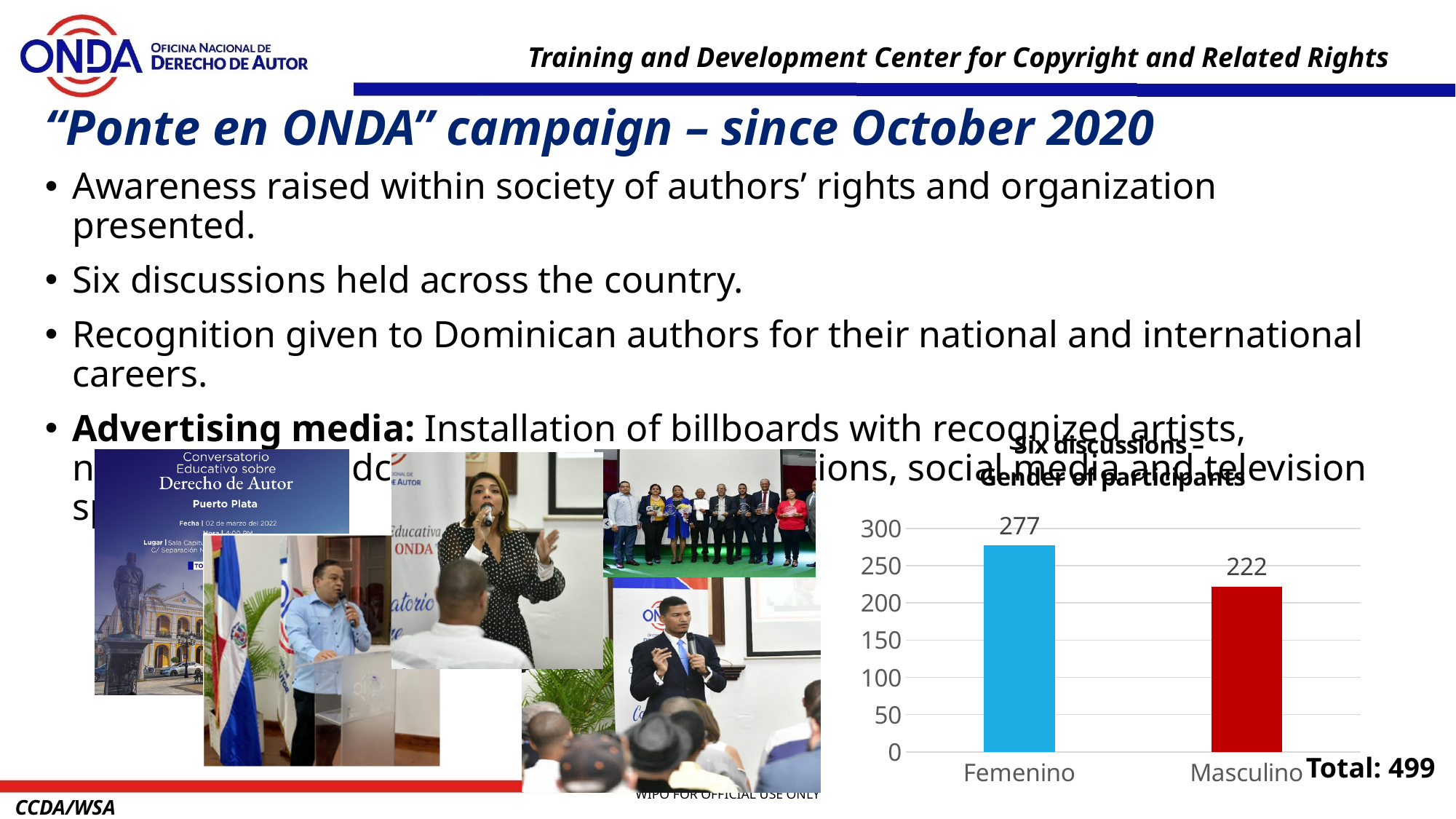
Which is larger, the value for Femenino or the value for Masculino? Femenino What colour is the bar for Masculino? red What total is printed next to the chart? Total: 499 What kind of chart is shown on the slide? bar chart What is the difference between the values for Femenino and Masculino? 55 Is the value for Masculino greater or less than 250? less What is the value for Masculino? 222 How many categories are shown on the chart? 2 Is the value for Femenino greater or less than 250? greater Which category has the lowest value? Masculino Which category has the highest value? Femenino What is the value for Femenino? 277